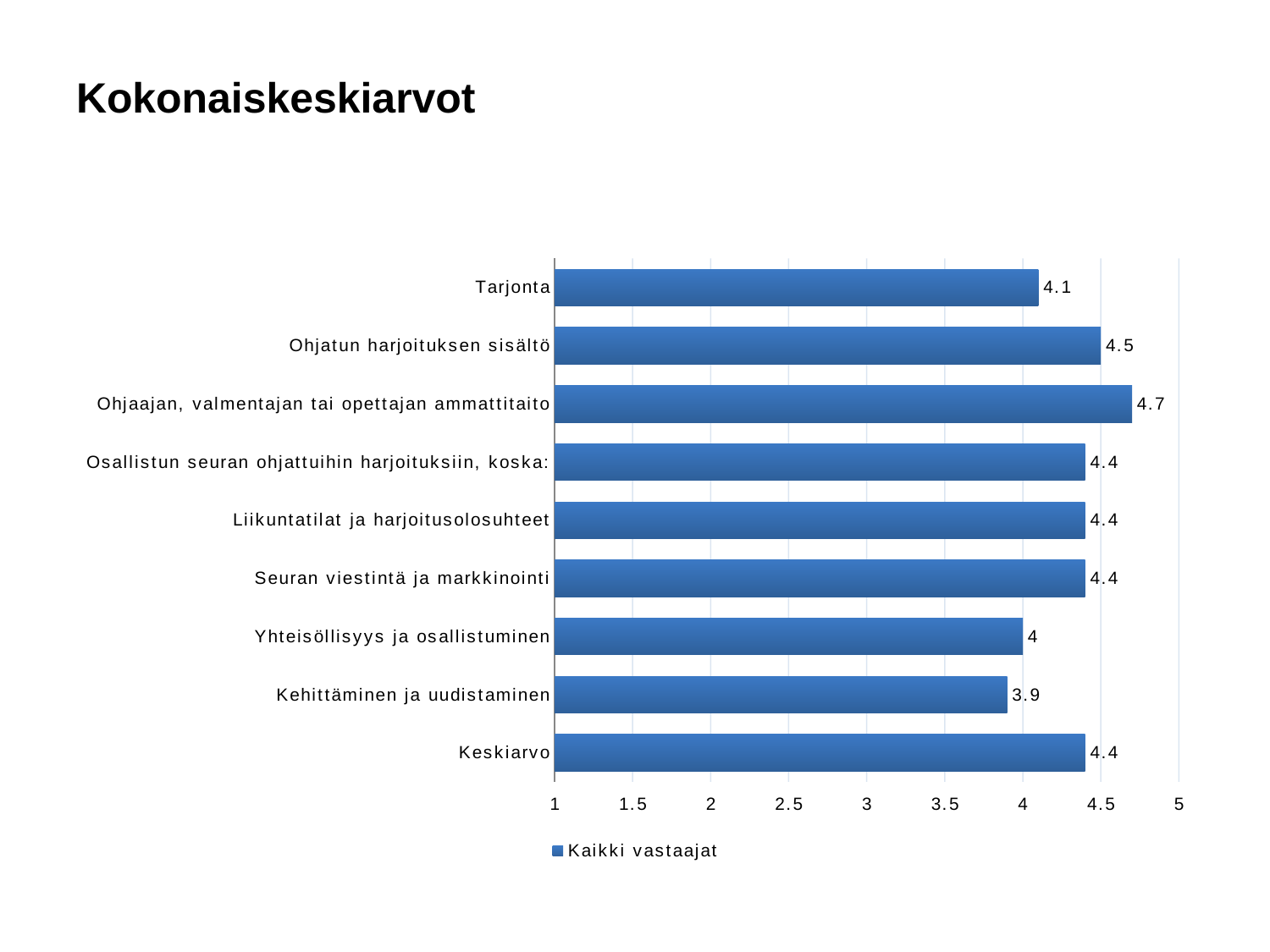
What is the value for Kehittäminen ja uudistaminen? 3.9 What is the title of the chart? Kokonaiskeskiarvot What kind of chart is shown on the slide? Bar chart What is the value for Ohjatun harjoituksen sisältö? 4.5 Which category has the highest value? Ohjaajan, valmentajan tai opettajan ammattitaito Which is larger, the value for Tarjonta or the value for Yhteisöllisyys ja osallistuminen? Tarjonta How many categories are shown in the chart? 9 Which category has the lowest value? Kehittäminen ja uudistaminen How many series does the legend list? 1 What is the value for Keskiarvo? 4.4 What is the value for Tarjonta? 4.1 What is the difference between the values for Ohjaajan, valmentajan tai opettajan ammattitaito and Kehittäminen ja uudistaminen? 0.8